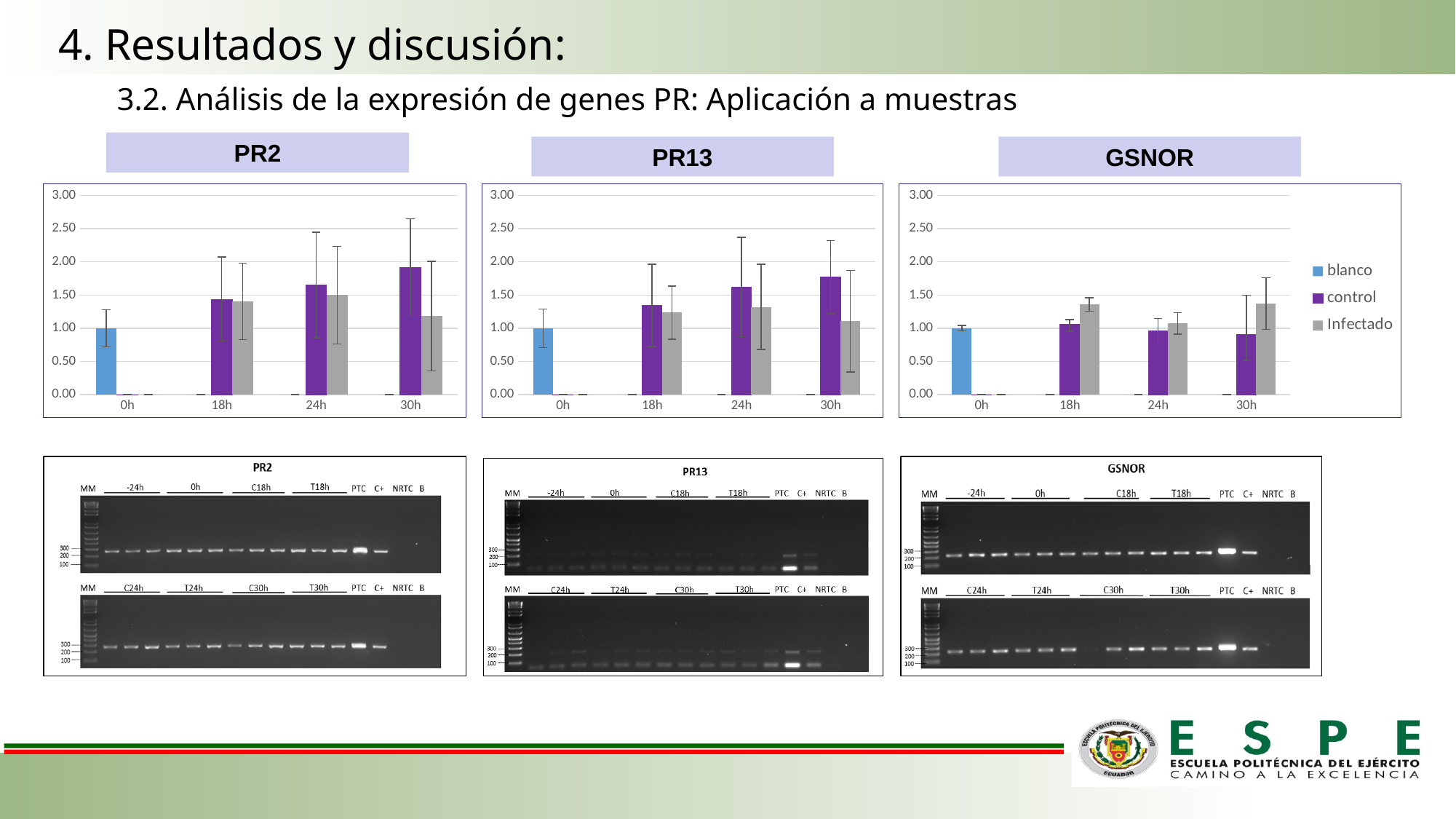
Which colour represents the Infectado series in the charts? grey What kind of chart is the PR2 chart? bar chart In the PR2 chart, is the Infectado value at 30h greater or less than 1.50? less In the GSNOR chart, do the control bars rise or fall from 18h to 30h? fall In the PR2 chart, at which time point is the control bar highest? 30h In the PR13 chart, is the control value at 30h greater or less than 1.50? greater In the PR13 chart, which is larger at 30h, the control bar or the Infectado bar? control In the PR2 chart, what is the value of the blanco bar at 0h? 1.00 How many time-point categories are shown on the x axis of the PR13 chart? 4 In the PR2 chart, is the control value at 30h greater or less than 1.50? greater In the GSNOR chart, which is larger at 18h, the control bar or the Infectado bar? Infectado How many series does the legend next to the GSNOR chart list? 3